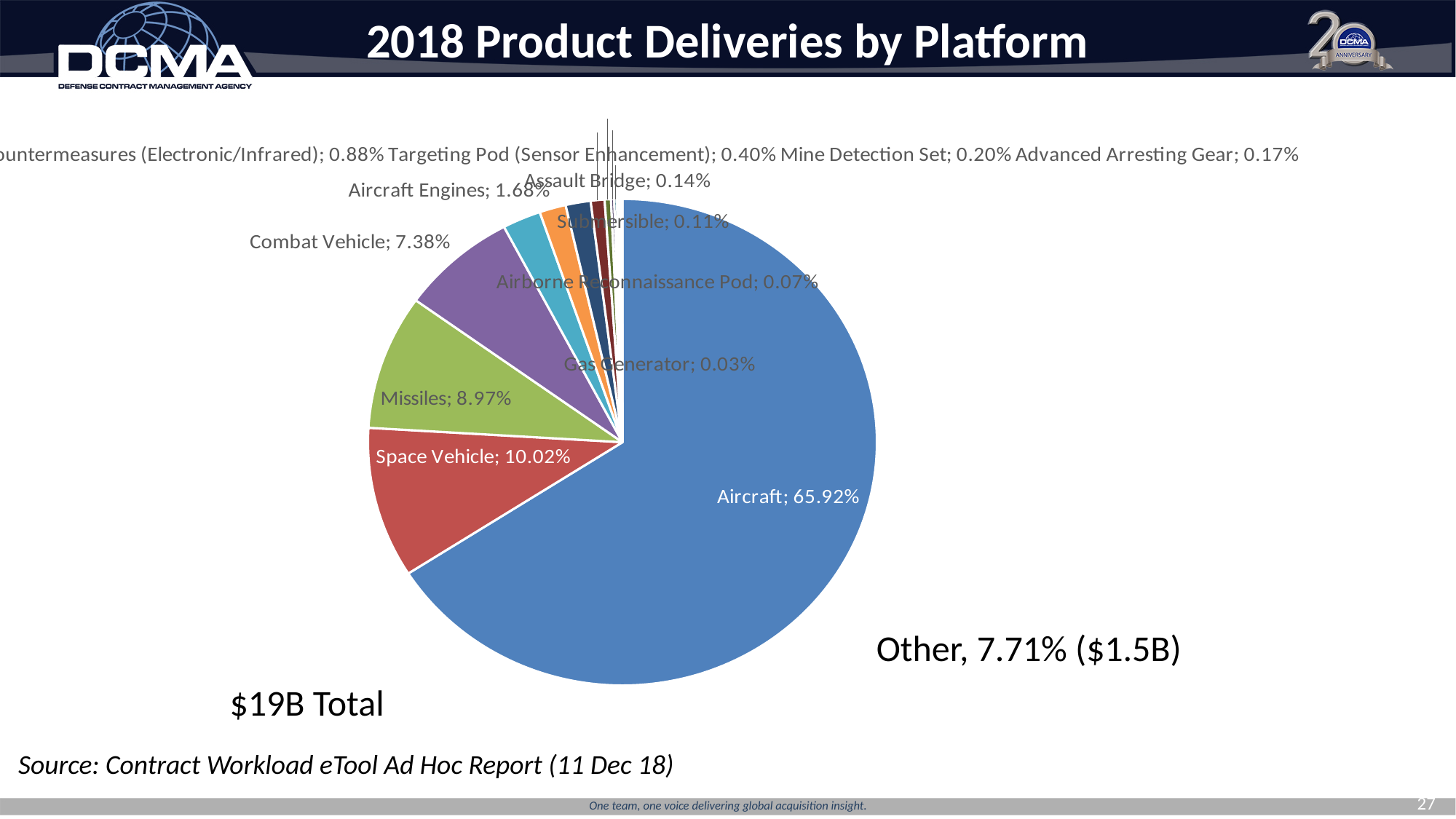
What share of 2018 product deliveries is Space Vehicle? 10.02% What dollar value is given for the 'Other' group of platforms? $1.5B What is the difference in share between Space Vehicle and Missiles? 1.05% Which platform has the smallest share of 2018 product deliveries? Gas Generator What share of 2018 product deliveries is Missiles? 8.97% What share of 2018 product deliveries is Aircraft? 65.92% What share of 2018 product deliveries is Combat Vehicle? 7.38% What share of 2018 product deliveries is Aircraft Engines? 1.68% Which has a larger share, Missiles or Combat Vehicle? Missiles What is the total dollar value of 2018 product deliveries shown on the slide? $19B Which platform has the largest share of 2018 product deliveries? Aircraft What kind of chart is shown on the slide? pie chart